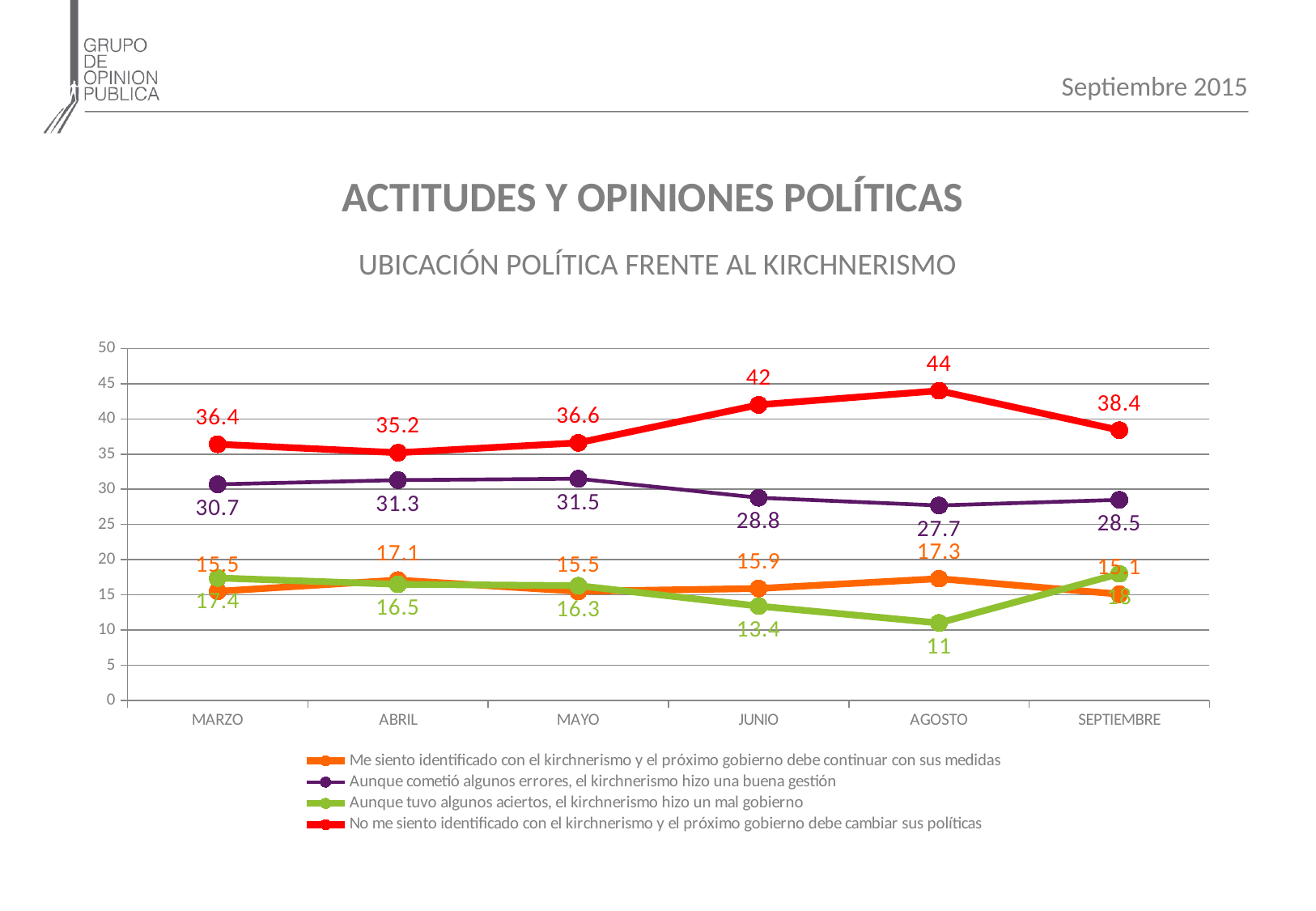
How many series does the legend list? 4 What is the value for 'No me siento identificado con el kirchnerismo y el próximo gobierno debe cambiar sus políticas' in AGOSTO? 44 What is the value for 'Aunque tuvo algunos aciertos, el kirchnerismo hizo un mal gobierno' in JUNIO? 13.4 What is the value for 'Aunque cometió algunos errores, el kirchnerismo hizo una buena gestión' in MARZO? 30.7 How many months are shown along the x axis? 6 Is the value for 'Aunque cometió algunos errores, el kirchnerismo hizo una buena gestión' in JUNIO greater or less than 30? less What kind of chart is shown on the slide? line chart In which month does the green series 'Aunque tuvo algunos aciertos, el kirchnerismo hizo un mal gobierno' reach its lowest value? AGOSTO Which is larger for the red series: the value in JUNIO or the value in MAYO? JUNIO Does the green series 'Aunque tuvo algunos aciertos, el kirchnerismo hizo un mal gobierno' rise or fall from MARZO to AGOSTO? fall In which month does the red series 'No me siento identificado con el kirchnerismo...' reach its highest value? AGOSTO What is the difference between the red series values in AGOSTO and JUNIO? 2